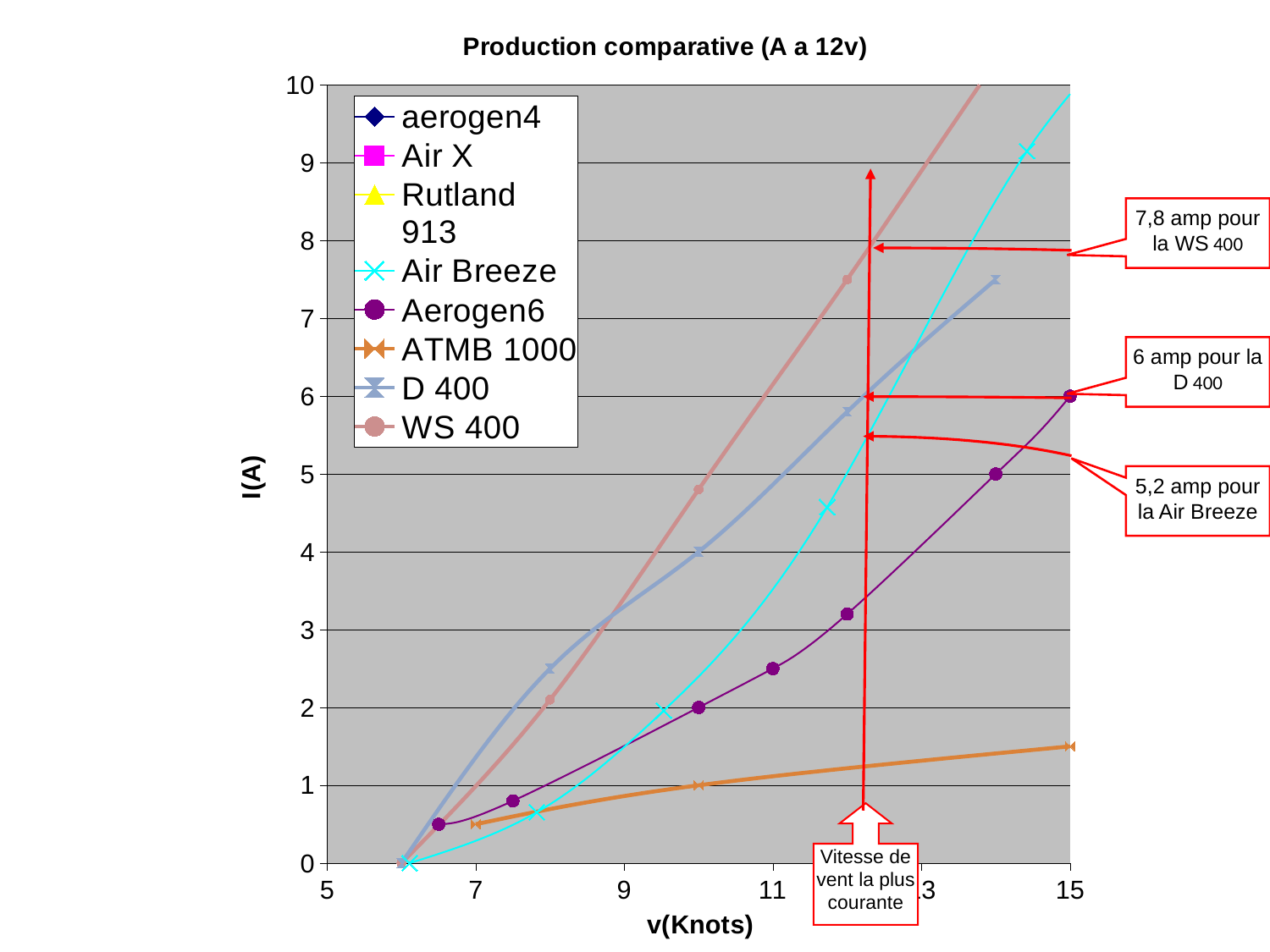
What is the title of the chart? Production comparative (A a 12v) What kind of chart is shown on the slide? line chart According to the annotation, what current does the D 400 produce at the most common wind speed? 6 amp According to the annotation, what current does the WS 400 produce at the most common wind speed? 7,8 amp How many series does the legend list? 8 What is the value of ATMB 1000 at 10 knots? 1 Is the value for ATMB 1000 at 15 knots greater or less than 2? less What is the value of Aerogen6 at 15 knots? 6 According to the annotation, what current does the Air Breeze produce at the most common wind speed? 5,2 amp Which series has the lowest value at 15 knots? ATMB 1000 At 10 knots, which is larger: D 400 or Aerogen6? D 400 What is the label of the x axis? v(Knots)